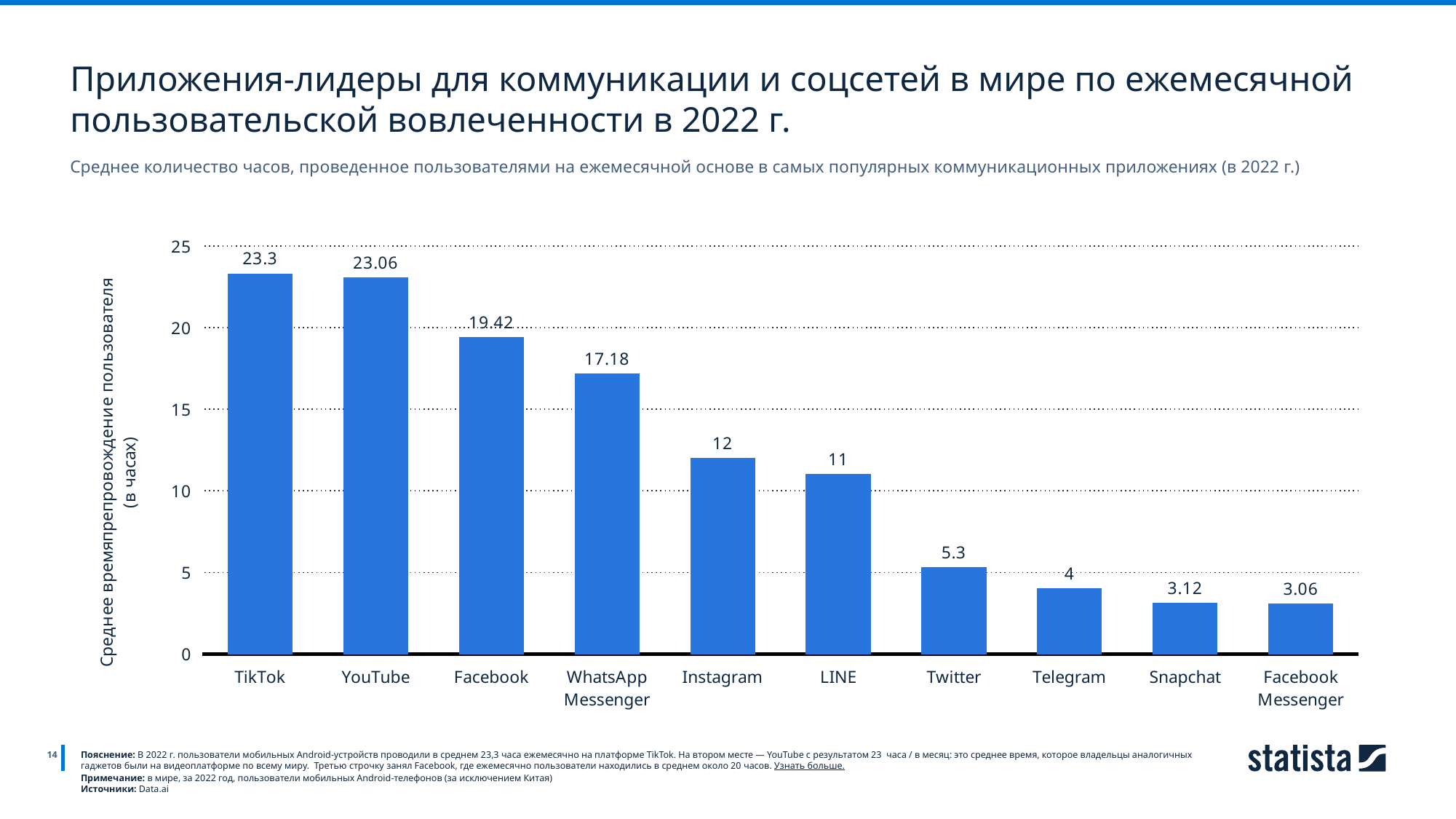
Which is larger, the value for LINE or the value for Instagram? Instagram What is the difference between the values for Facebook and Instagram? 7.42 What kind of chart is shown on the slide? bar chart Do the values rise or fall from left to right along the x axis? fall What is the value for TikTok? 23.3 How many apps are shown in the chart? 10 Which app has the lowest value? Facebook Messenger Is the value for YouTube greater or less than 20? greater What is the difference between the values for Twitter and Telegram? 1.3 Which app has the highest value? TikTok What is the value for Snapchat? 3.12 What is the value for WhatsApp Messenger? 17.18